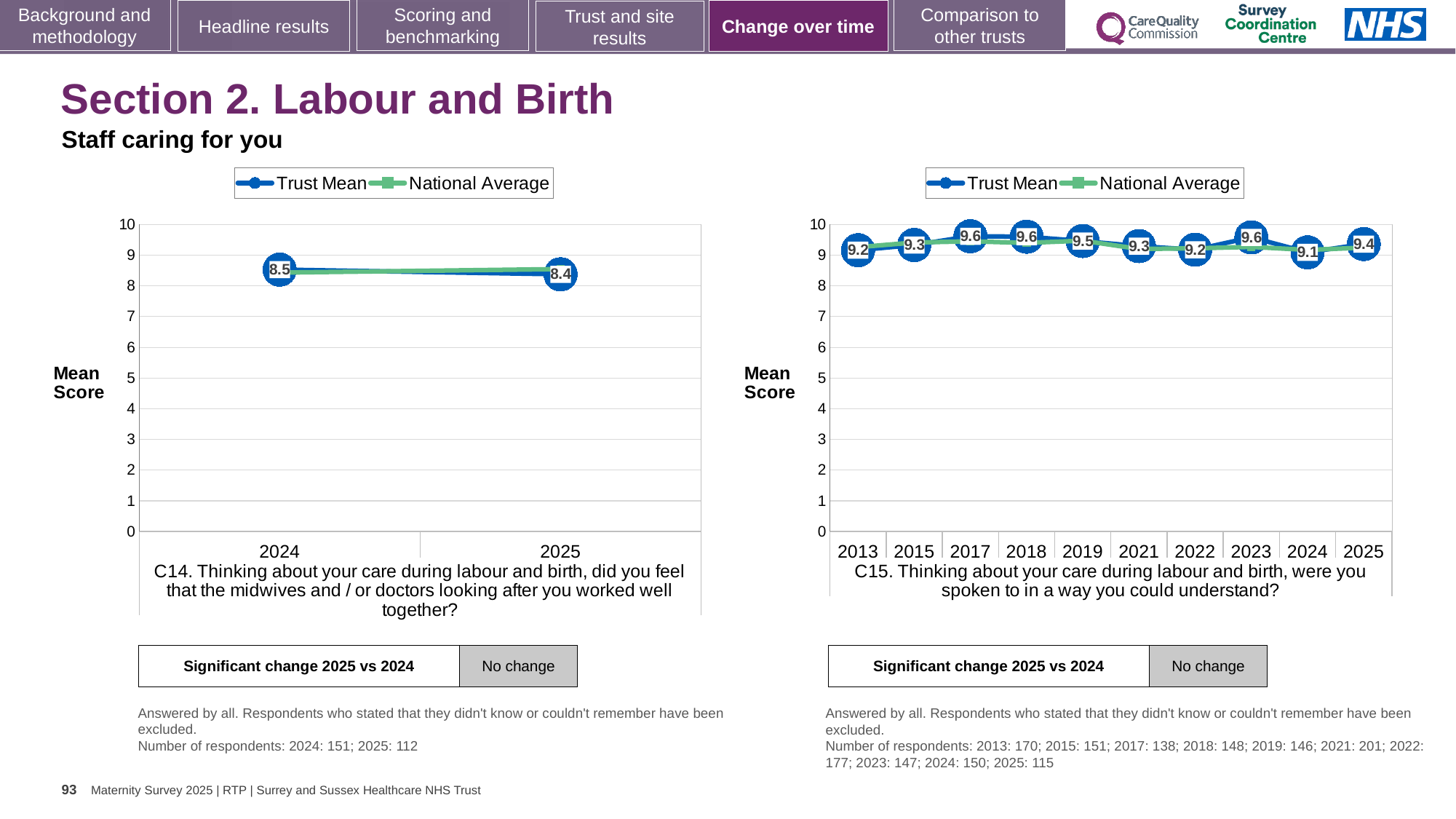
In the right chart (C15), is the Trust Mean score for 2019 greater or less than 9? greater In the right chart (C15), which series is shown in green in the legend? National Average In the left chart (C14), what is the difference between the Trust Mean scores for 2024 and 2025? 0.1 In the left chart (C14), what is the Trust Mean score for 2025? 8.4 In the right chart (C15), what is the Trust Mean score for 2025? 9.4 In the right chart (C15), which year has the lowest Trust Mean score? 2024 In the left chart (C14), what is the Trust Mean score for 2024? 8.5 In the right chart (C15), what is the Trust Mean score for 2024? 9.1 What kind of chart is the right chart (C15)? Line chart In the left chart (C14), how many series does the legend list? 2 In the right chart (C15), what is the difference between the Trust Mean scores for 2025 and 2024? 0.3 In the right chart (C15), how many years are plotted on the x axis? 10